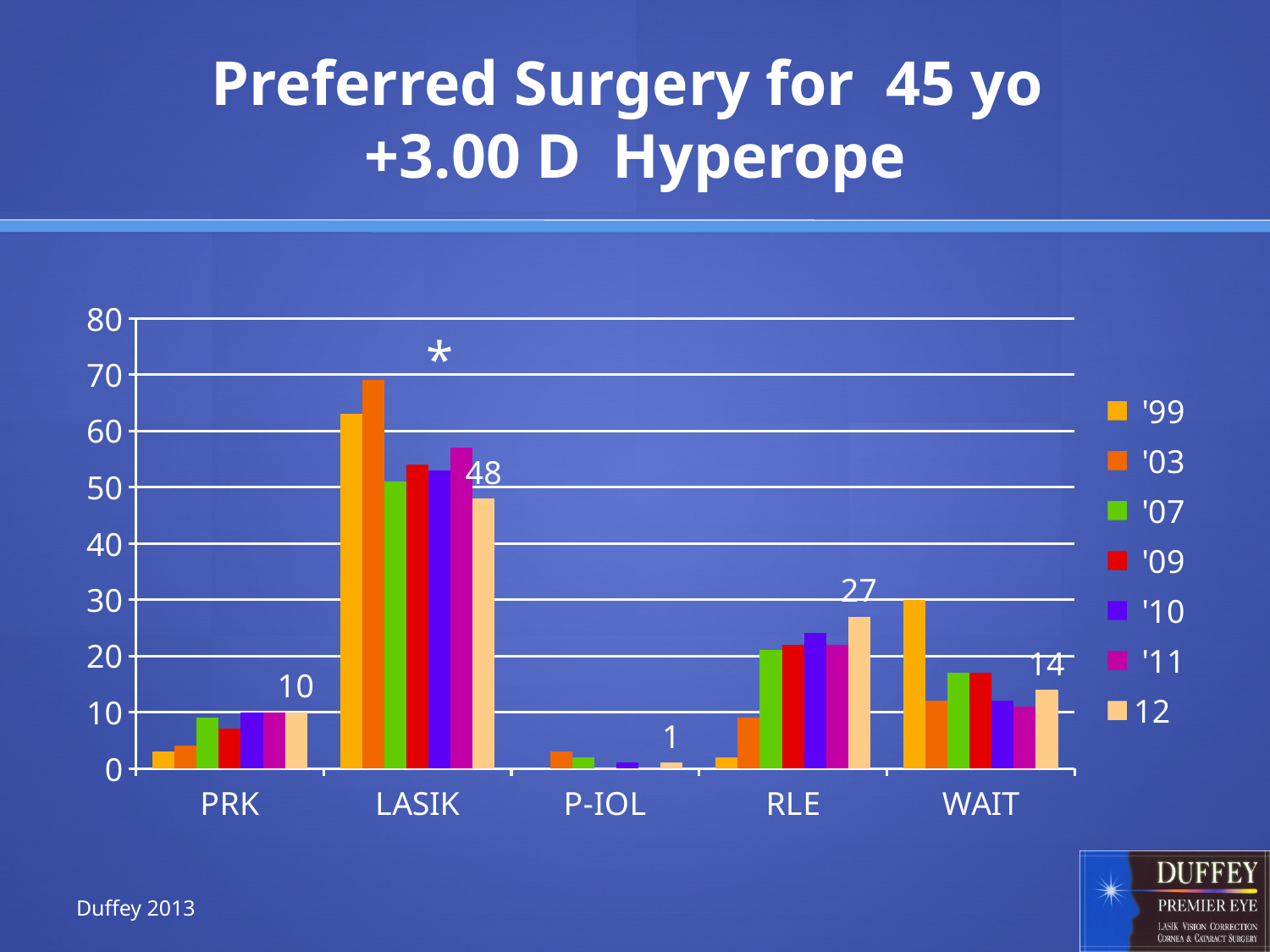
What is the value for P-IOL in the '12 series? 1 In the '12 series, which is larger: RLE or WAIT? RLE What is the difference between the '12 values for LASIK and RLE? 21 Which category has the highest value in the '12 series? LASIK How many series does the legend list? 7 Which category has the lowest value in the '12 series? P-IOL How many surgery categories are shown on the x axis? 5 What is the value for WAIT in the '12 series? 14 What is the value for RLE in the '12 series? 27 What kind of chart is shown on the slide? bar chart Is the value for LASIK in the '03 series greater or less than 60? greater What is the value for LASIK in the '12 series? 48